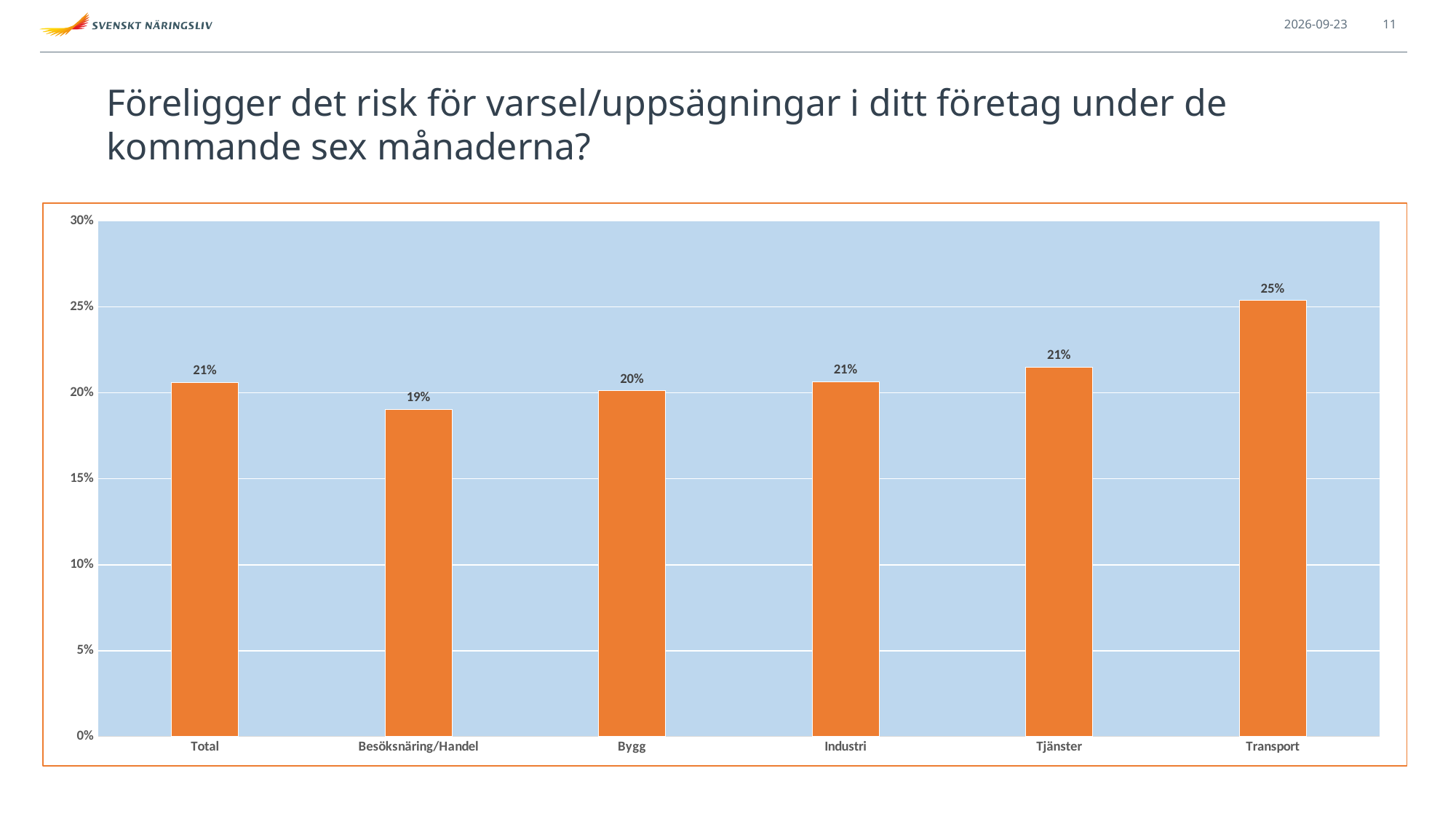
What colour are the bars in the chart? orange What is the value for Transport? 25% Is the value for Transport greater or less than 20%? greater What is the value for Total? 21% Which is larger, the value for Transport or the value for Bygg? Transport Which category has the highest value? Transport What is the difference between the values for Transport and Besöksnäring/Handel? 6 percentage points What kind of chart is shown on the slide? bar chart What is the value for Besöksnäring/Handel? 19% How many categories are shown on the x axis? 6 What is the value for Bygg? 20% Which category has the lowest value? Besöksnäring/Handel